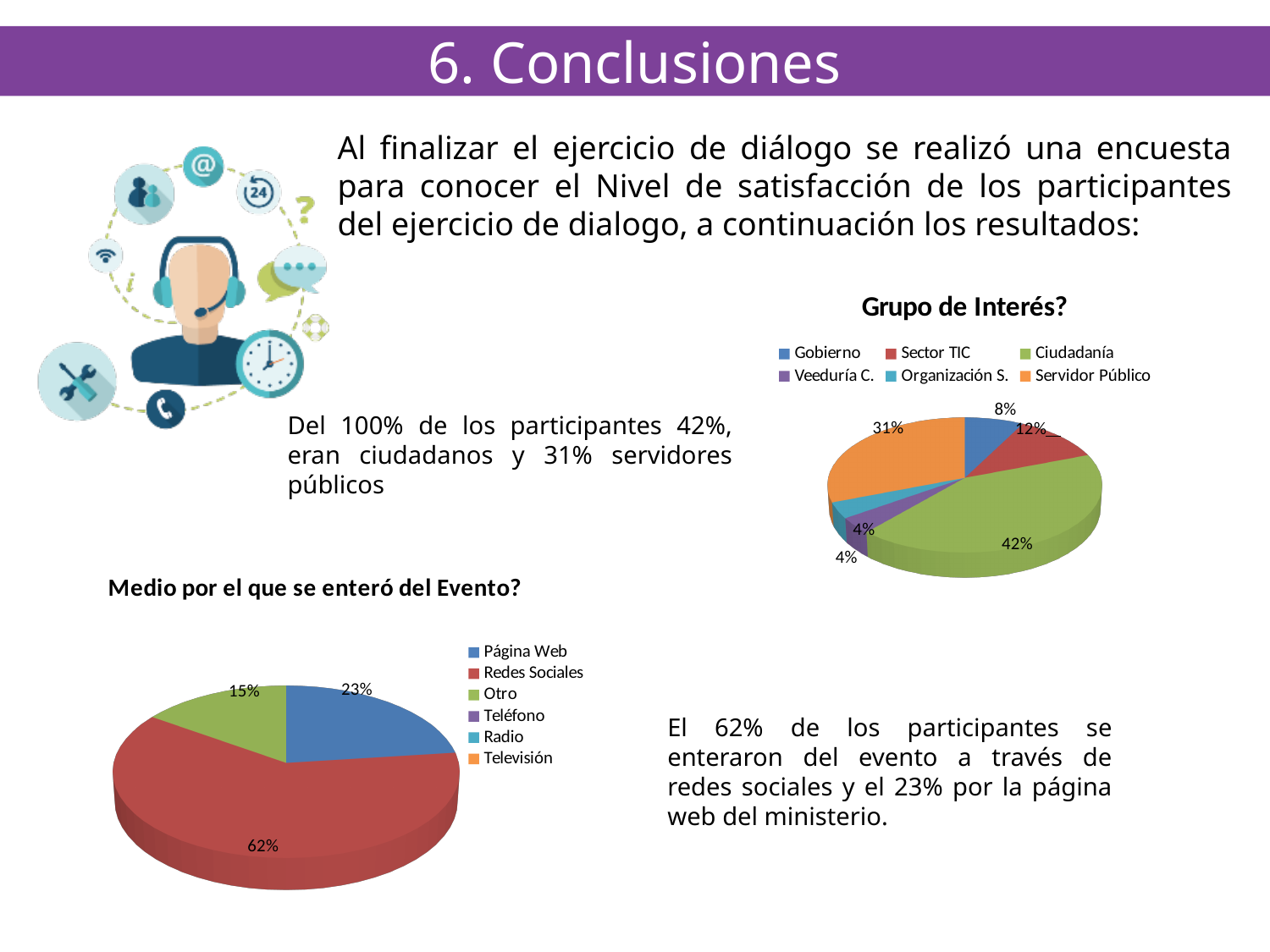
In the 'Grupo de Interés?' chart, which is larger, Gobierno or Sector TIC? Sector TIC In the 'Medio por el que se enteró del Evento?' chart, what share corresponds to Redes Sociales? 62% In the 'Grupo de Interés?' chart, what percentage corresponds to Servidor Público? 31% In the 'Grupo de Interés?' chart, which group has the largest share? Ciudadanía What type of chart is 'Medio por el que se enteró del Evento?'? Pie chart In the 'Grupo de Interés?' chart, what share of participants were Ciudadanía? 42% In the 'Medio por el que se enteró del Evento?' chart, what share corresponds to Otro? 15% How many entries does the legend of the 'Grupo de Interés?' chart list? 6 In the 'Grupo de Interés?' chart, what is the difference between the Ciudadanía share and the Servidor Público share? 11% In the 'Grupo de Interés?' chart, what percentage corresponds to Sector TIC? 12% In the 'Medio por el que se enteró del Evento?' chart, which colour represents Redes Sociales? Red In the 'Medio por el que se enteró del Evento?' chart, what is the difference between Redes Sociales and Página Web? 39%